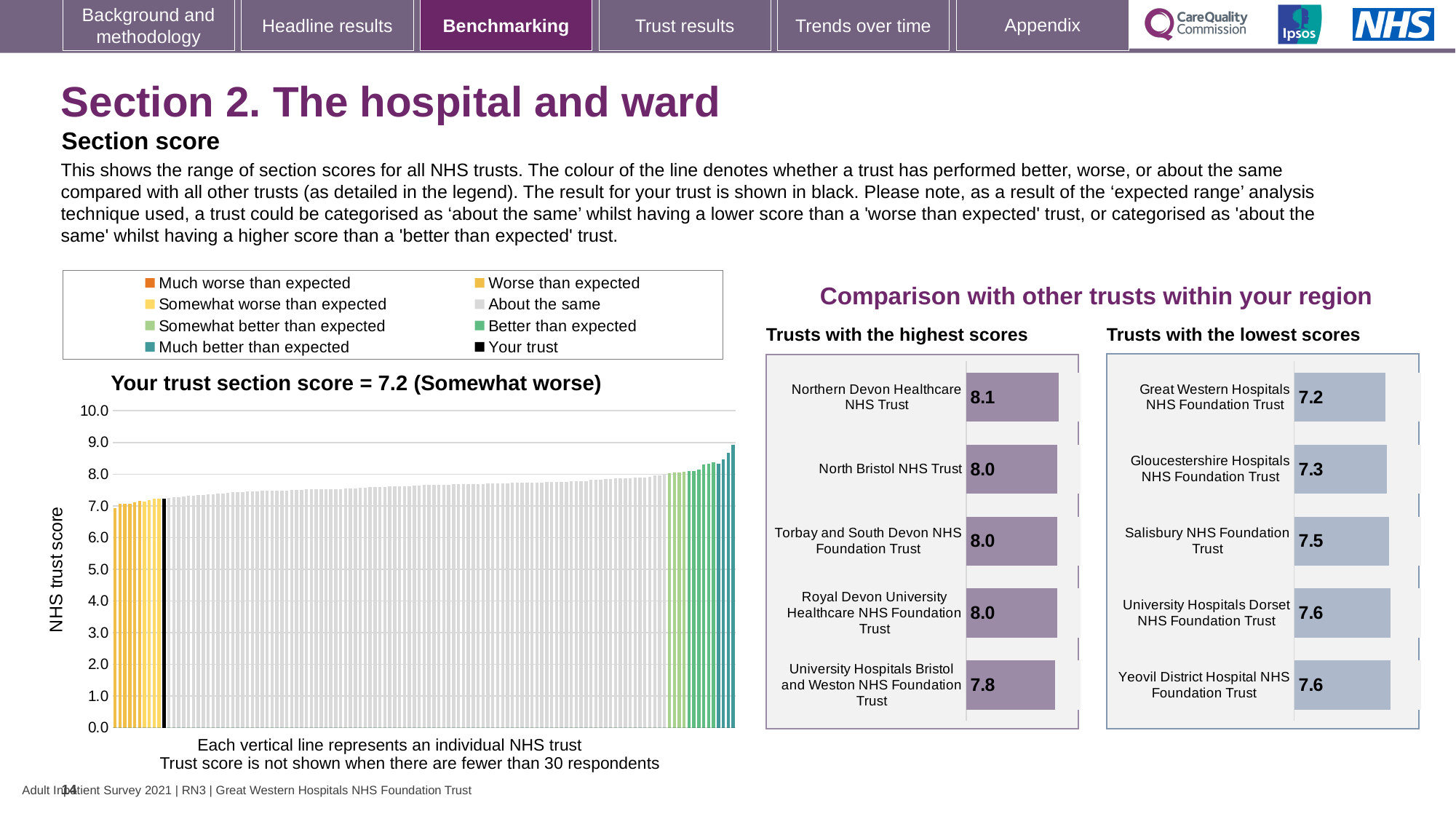
According to the title of the chart on the left, what is your trust's section score? 7.2 In the chart on the left, do the trust scores rise or fall from left to right? Rise In the 'Trusts with the highest scores' chart, what is the score for University Hospitals Bristol and Weston NHS Foundation Trust? 7.8 In the 'Trusts with the lowest scores' chart, which trust has the lowest score? Great Western Hospitals NHS Foundation Trust What kind of chart is the 'Your trust section score' chart on the left of the slide? Bar chart How many trusts are shown in the 'Trusts with the highest scores' chart? 5 In the 'Trusts with the lowest scores' chart, which has the higher score: Gloucestershire Hospitals NHS Foundation Trust or University Hospitals Dorset NHS Foundation Trust? University Hospitals Dorset NHS Foundation Trust In the 'Trusts with the highest scores' chart, what is the score for Northern Devon Healthcare NHS Trust? 8.1 In the 'Trusts with the highest scores' chart, what is the difference between the scores of Northern Devon Healthcare NHS Trust and University Hospitals Bristol and Weston NHS Foundation Trust? 0.3 In the 'Trusts with the highest scores' chart, which trust has the highest score? Northern Devon Healthcare NHS Trust What is the y-axis label of the chart on the left? NHS trust score In the 'Trusts with the lowest scores' chart, what is the score for Salisbury NHS Foundation Trust? 7.5